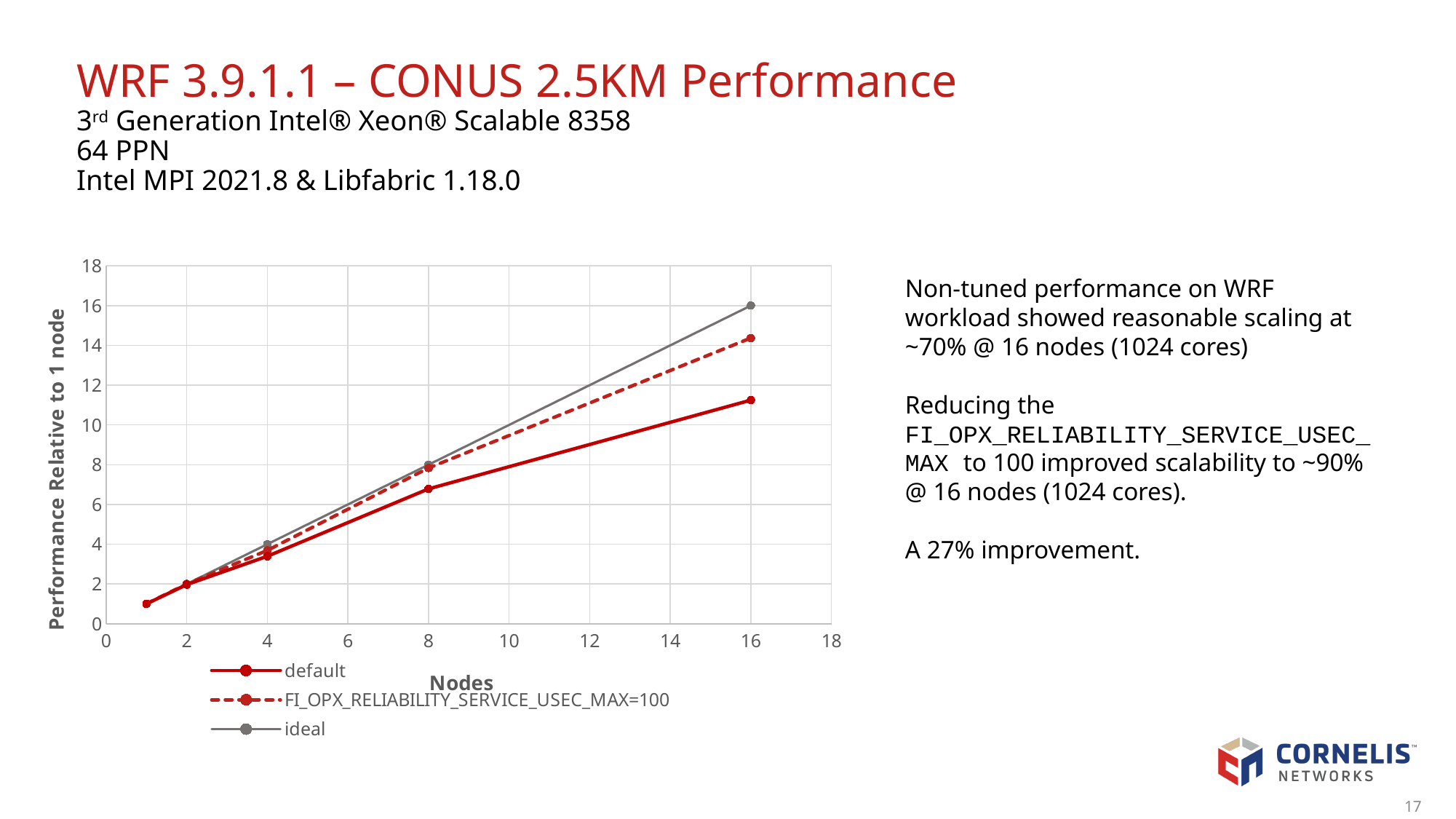
What is the value of the ideal series at 8 nodes? 8 What is the value of the ideal series at 16 nodes? 16 At 16 nodes, which is larger: the default series or the FI_OPX_RELIABILITY_SERVICE_USEC_MAX=100 series? FI_OPX_RELIABILITY_SERVICE_USEC_MAX=100 Is the value for the default series at 16 nodes greater or less than 12? less Is the value for the FI_OPX_RELIABILITY_SERVICE_USEC_MAX=100 series at 16 nodes greater or less than 14? greater What is the title of the chart's vertical axis? Performance Relative to 1 node How many series does the chart legend list? 3 Which series has the highest value at 16 nodes? ideal What kind of chart is shown on the slide? line chart How many data points are plotted for the default series? 5 Do the values of the default series rise or fall as the number of nodes increases? rise Which series has the lowest value at 16 nodes? default